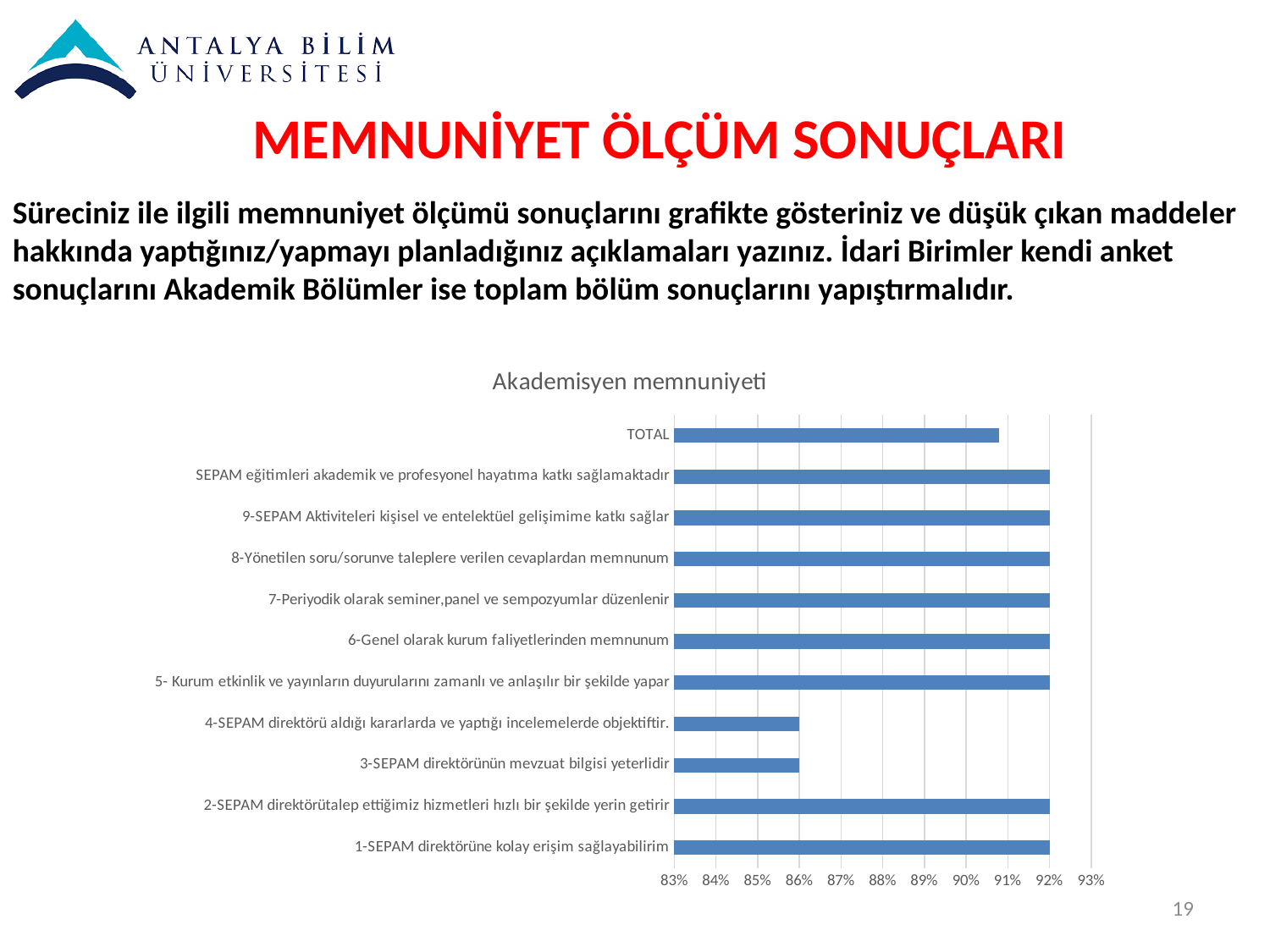
What is the value for "4-SEPAM direktörü aldığı kararlarda ve yaptığı incelemelerde objektiftir."? 86% What is the lowest value shown on the horizontal axis? 83% What kind of chart is shown on the slide? bar chart Which category has the lowest value, "3-SEPAM direktörünün mevzuat bilgisi yeterlidir" or "6-Genel olarak kurum faliyetlerinden memnunum"? 3-SEPAM direktörünün mevzuat bilgisi yeterlidir How many categories (bars) does the chart show? 11 Is the value for TOTAL greater or less than 90%? greater What is the value for "3-SEPAM direktörünün mevzuat bilgisi yeterlidir"? 86% What is the difference between the value for "1-SEPAM direktörüne kolay erişim sağlayabilirim" and the value for "3-SEPAM direktörünün mevzuat bilgisi yeterlidir"? 6% What is the title of the chart? Akademisyen memnuniyeti Which is larger, the value for "2-SEPAM direktörütalep ettiğimiz hizmetleri hızlı bir şekilde yerin getirir" or the value for TOTAL? 2-SEPAM direktörütalep ettiğimiz hizmetleri hızlı bir şekilde yerin getirir What is the value for "1-SEPAM direktörüne kolay erişim sağlayabilirim"? 92%